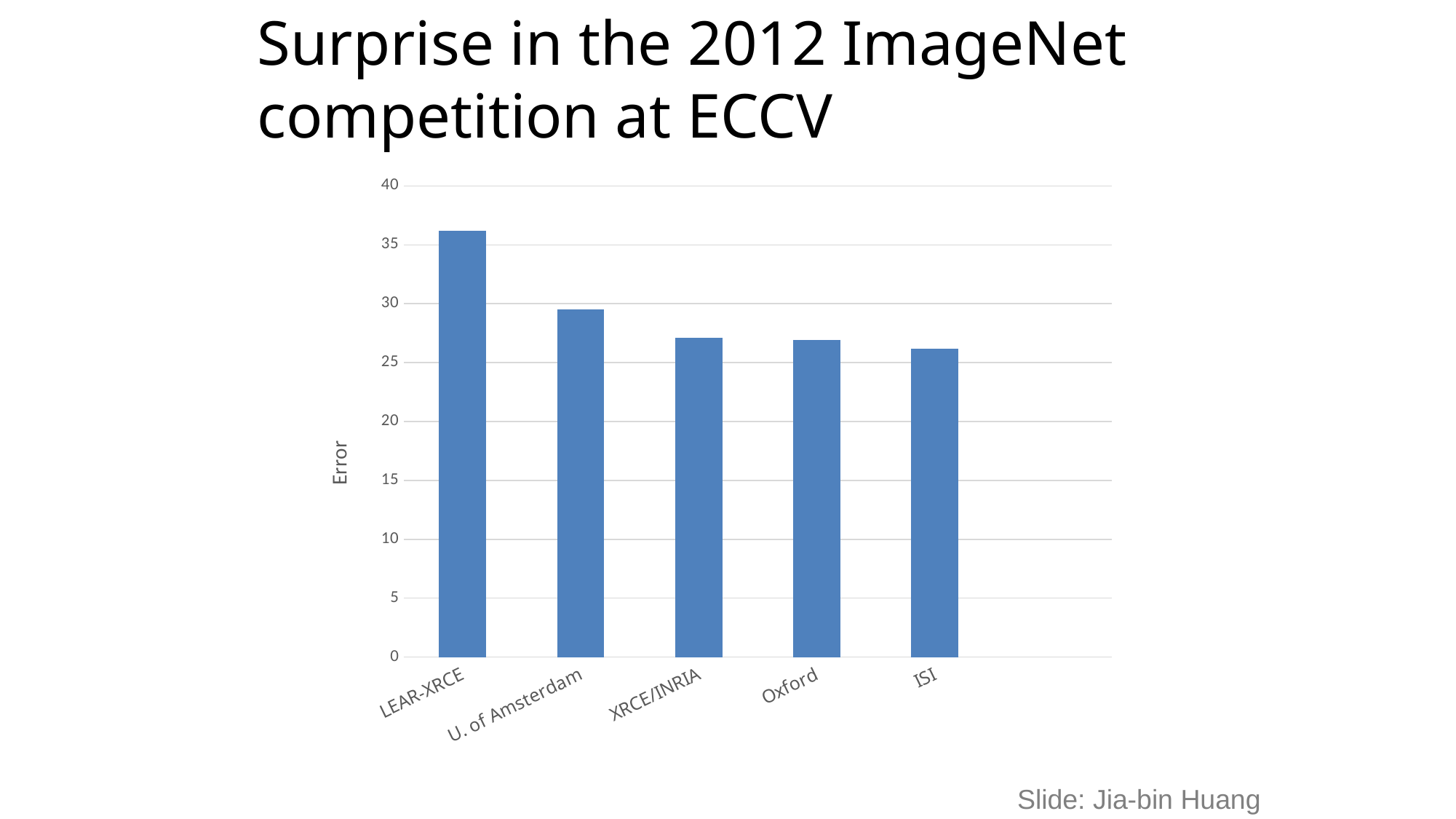
Which has a higher error, U. of Amsterdam or ISI? U. of Amsterdam Which team has the highest error in the chart? LEAR-XRCE Is the error for Oxford greater or less than 25? greater What kind of chart is shown on the slide? bar chart Which has a higher error, LEAR-XRCE or ISI? LEAR-XRCE How many teams (categories) are shown in the chart? 5 Is the error for LEAR-XRCE greater or less than 35? greater Is the error for U. of Amsterdam greater or less than 30? less Do the error values rise or fall from left to right across the chart? fall What is the label on the vertical axis of the chart? Error